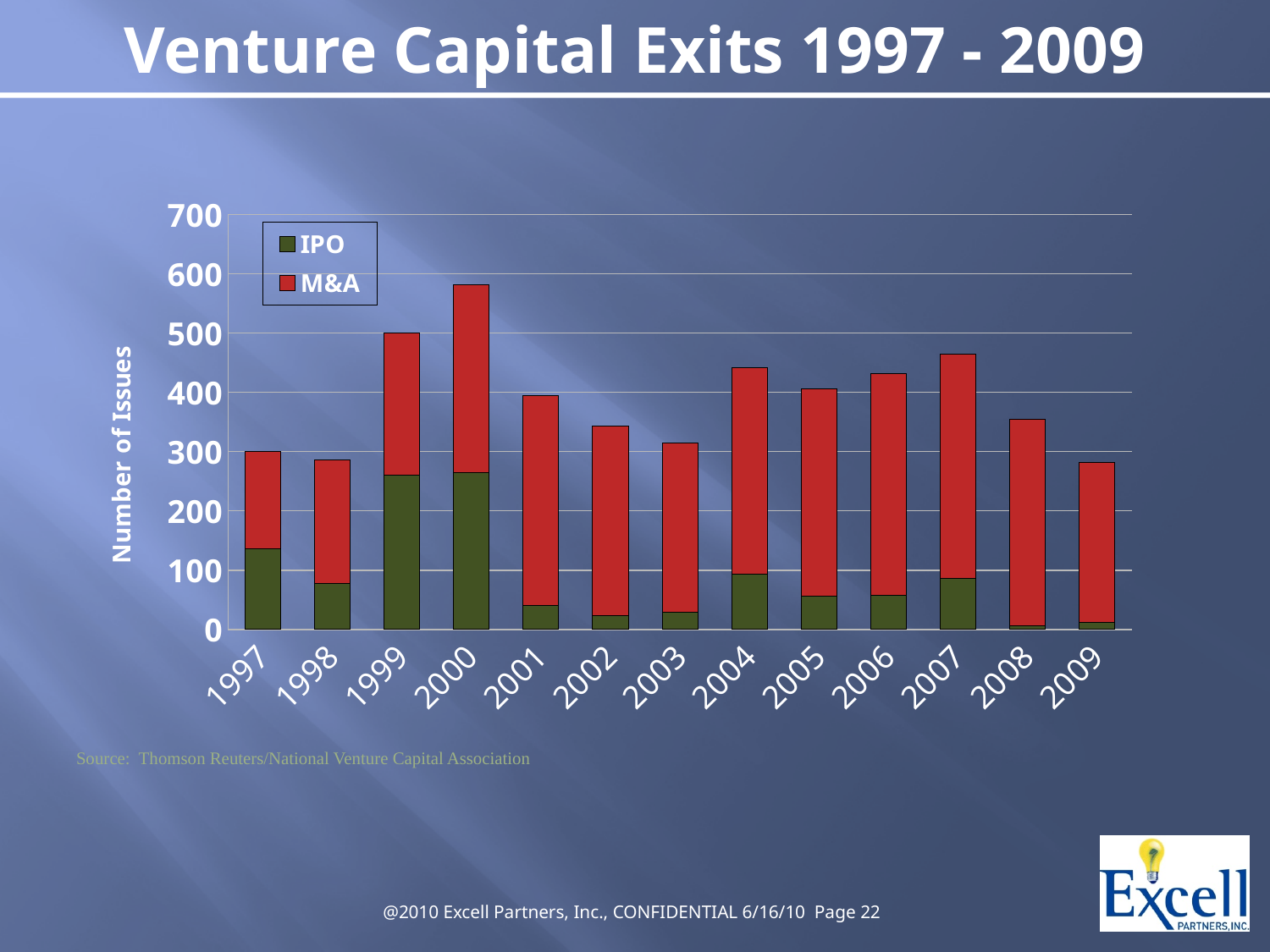
What is the label on the y axis? Number of Issues Do the total number of issues rise or fall from 2000 to 2003? fall Is the total number of issues for 2003 greater or less than 400? less How many series does the legend list? 2 Which year has the larger IPO value, 1999 or 2001? 1999 Is the total number of issues for 2000 greater or less than 500? greater What kind of chart is shown on the slide? Stacked bar chart Which year has the larger total number of issues, 2007 or 2008? 2007 Which series is shown in red? M&A How many years are shown along the x axis? 13 Which year has the highest total number of issues? 2000 Is the total number of issues for 2007 greater or less than 400? greater